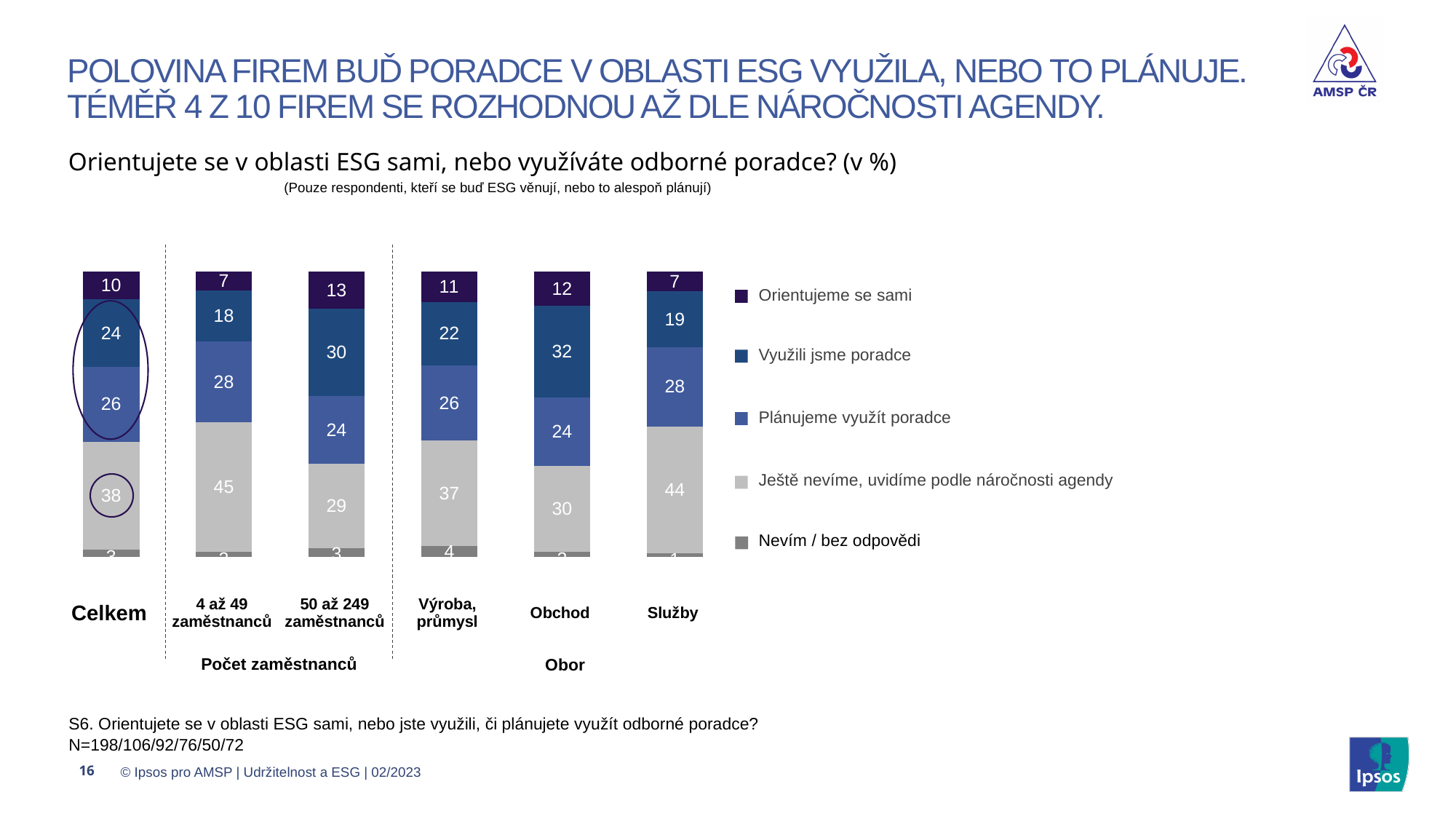
How many bars (categories) are plotted in the chart? 6 What is the value for 'Orientujeme se sami' in the 50 až 249 zaměstnanců bar? 13 Which is larger: the 'Orientujeme se sami' value for Výroba, průmysl or for Služby? Výroba, průmysl Which legend entry is shown in the lightest grey colour? Ještě nevíme, uvidíme podle náročnosti agendy Which category has the highest value for 'Ještě nevíme, uvidíme podle náročnosti agendy'? 4 až 49 zaměstnanců What is the difference between the 'Využili jsme poradce' values for Obchod and Služby? 13 What is the value for 'Plánujeme využít poradce' in the Služby bar? 28 What kind of chart is shown on the slide? stacked bar chart Which category has the lowest value for 'Využili jsme poradce'? 4 až 49 zaměstnanců What is the value for 'Využili jsme poradce' in the Obchod bar? 32 How many series does the legend list? 5 What is the value for 'Ještě nevíme, uvidíme podle náročnosti agendy' in the Celkem bar? 38